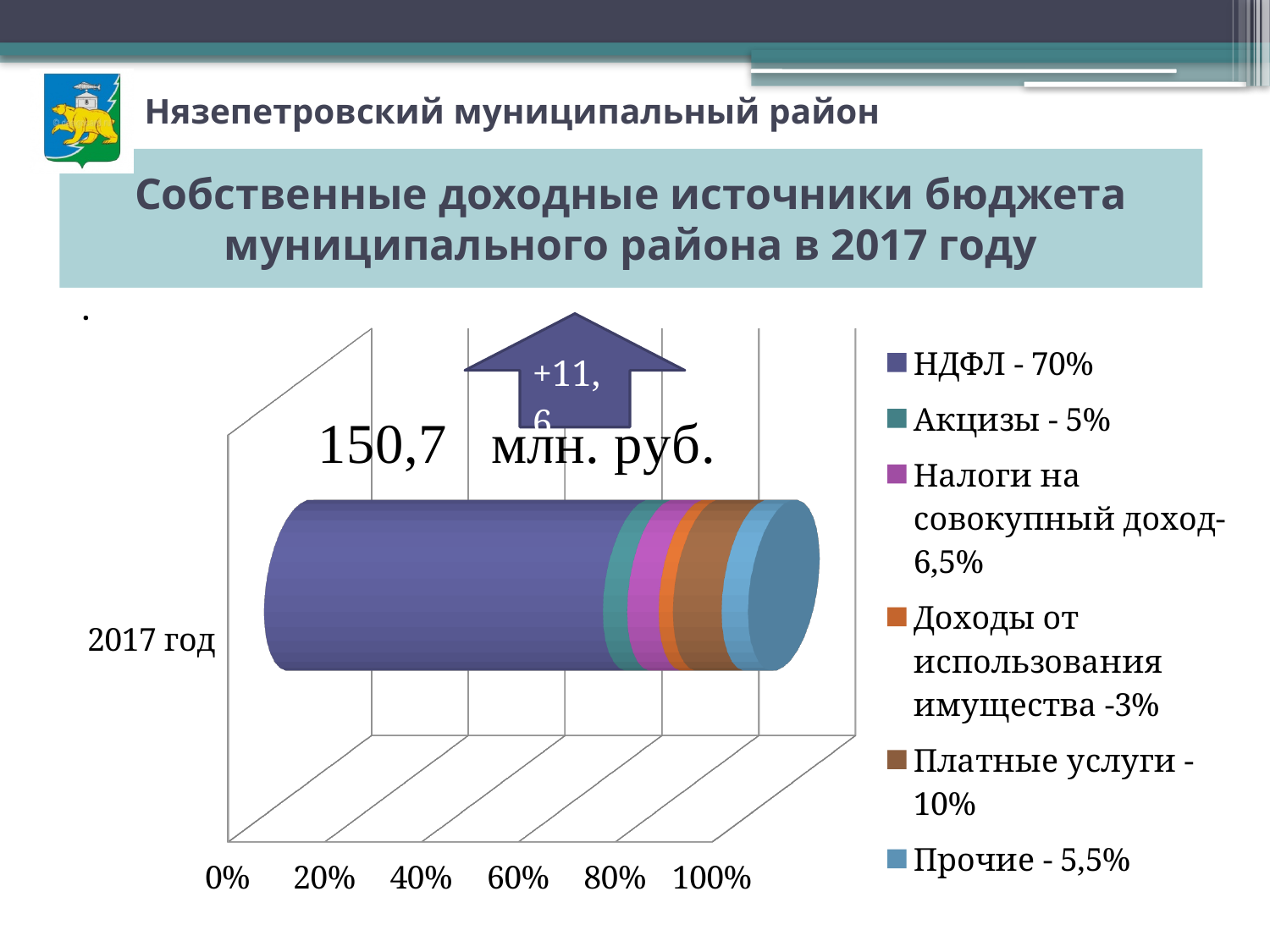
Which year is shown as the category on the vertical axis? 2017 год What share does Доходы от использования имущества account for, according to the legend? 3% What share does Платные услуги account for, according to the legend? 10% What kind of chart is shown on the slide? bar chart How many series does the legend list? 6 What is the difference between the share of НДФЛ and the share of Платные услуги? 60% Which revenue source has the largest share in the 2017 bar? НДФЛ Which is larger: the share of Акцизы or the share of Прочие? Прочие Which revenue source has the smallest share in the 2017 bar? Доходы от использования имущества What total amount in million rubles is printed above the bar? 150,7 млн. руб. What share does Налоги на совокупный доход account for, according to the legend? 6,5% What share of the 2017 budget revenue does НДФЛ account for, according to the legend? 70%